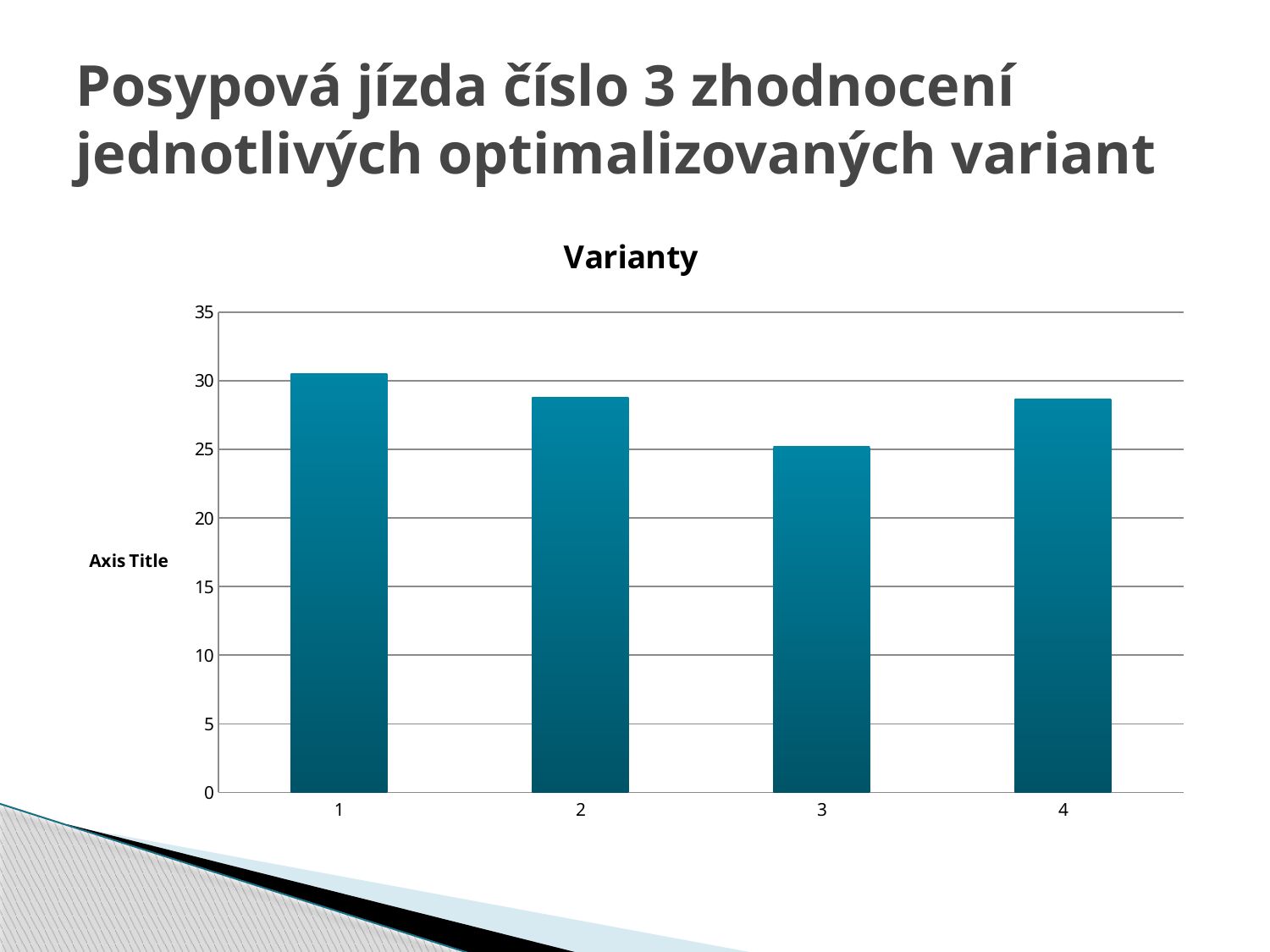
What is the title of the chart? Varianty Which category has the lowest bar? 3 Which is larger, the value for category 1 or category 3? category 1 Is the value for category 2 greater or less than 25? greater Is the value for category 3 greater or less than 30? less Which category has the highest bar? 1 What kind of chart is shown on the slide? bar chart What label is shown on the vertical axis of the chart? Axis Title Which is larger, the value for category 3 or category 4? category 4 How many categories are plotted in the chart? 4 Is the value for category 4 greater or less than 30? less